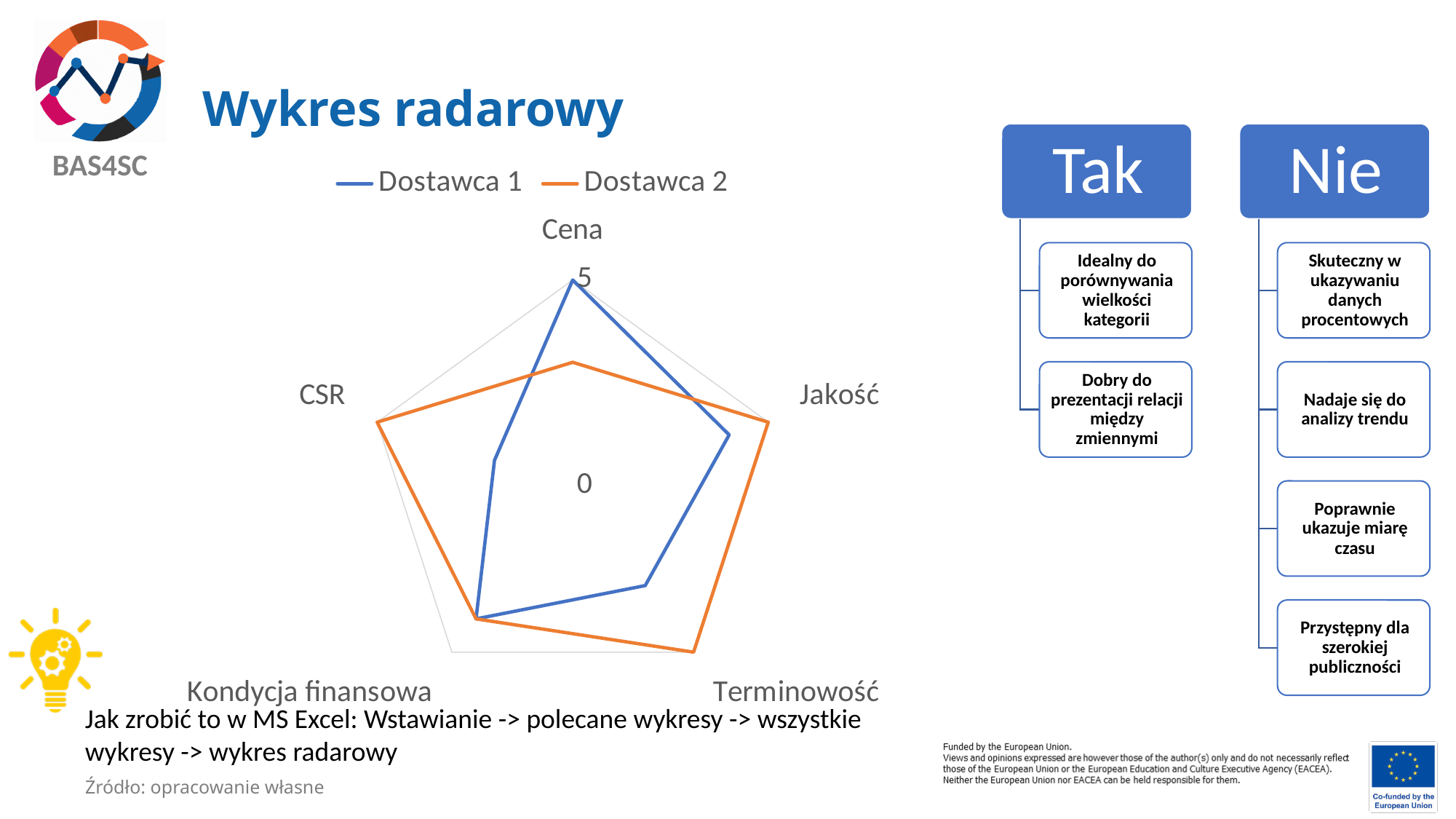
On the CSR axis, which series has the larger value, Dostawca 1 or Dostawca 2? Dostawca 2 What kind of chart is shown on the slide? Radar chart What is the value for Dostawca 2 on the Jakość axis? 5 What is the value for Dostawca 1 on the Cena axis? 5 On which axis does Dostawca 2 have its lowest value? Cena On which axis does Dostawca 1 have its highest value? Cena What is the value for Dostawca 2 on the CSR axis? 5 How many categories (axes) does the radar chart have? 5 On the Terminowość axis, which series has the larger value, Dostawca 1 or Dostawca 2? Dostawca 2 Which colour represents Dostawca 2 in the chart? Orange On the Cena axis, which series has the larger value, Dostawca 1 or Dostawca 2? Dostawca 1 How many series does the legend list? 2